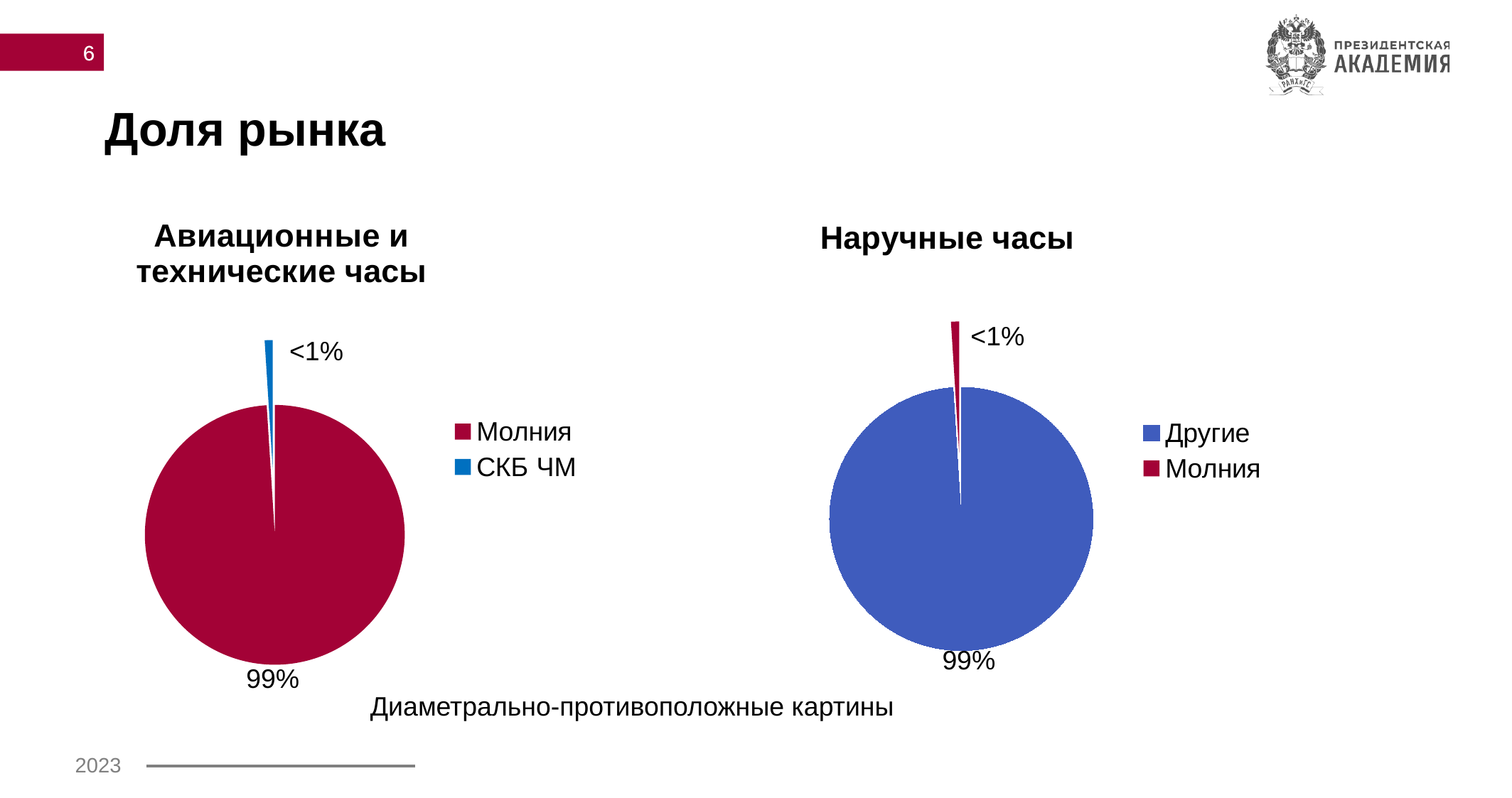
In the 'Наручные часы' chart, which category has the largest slice? Другие In the 'Авиационные и технические часы' chart, what share does Молния hold? 99% In the 'Наручные часы' chart, what share does Другие hold? 99% In the 'Авиационные и технические часы' chart, which category has the largest slice? Молния How many categories does the legend of the 'Наручные часы' chart list? 2 What colour is the Молния slice in the 'Наручные часы' chart? Dark red In the 'Авиационные и технические часы' chart, what share does СКБ ЧМ hold? <1% In the 'Наручные часы' chart, what share does Молния hold? <1% How many categories does the legend of the 'Авиационные и технические часы' chart list? 2 In the 'Наручные часы' chart, which is larger: Другие or Молния? Другие What type of chart is used in the 'Авиационные и технические часы' chart? Pie chart In the 'Авиационные и технические часы' chart, which category has the smallest slice? СКБ ЧМ